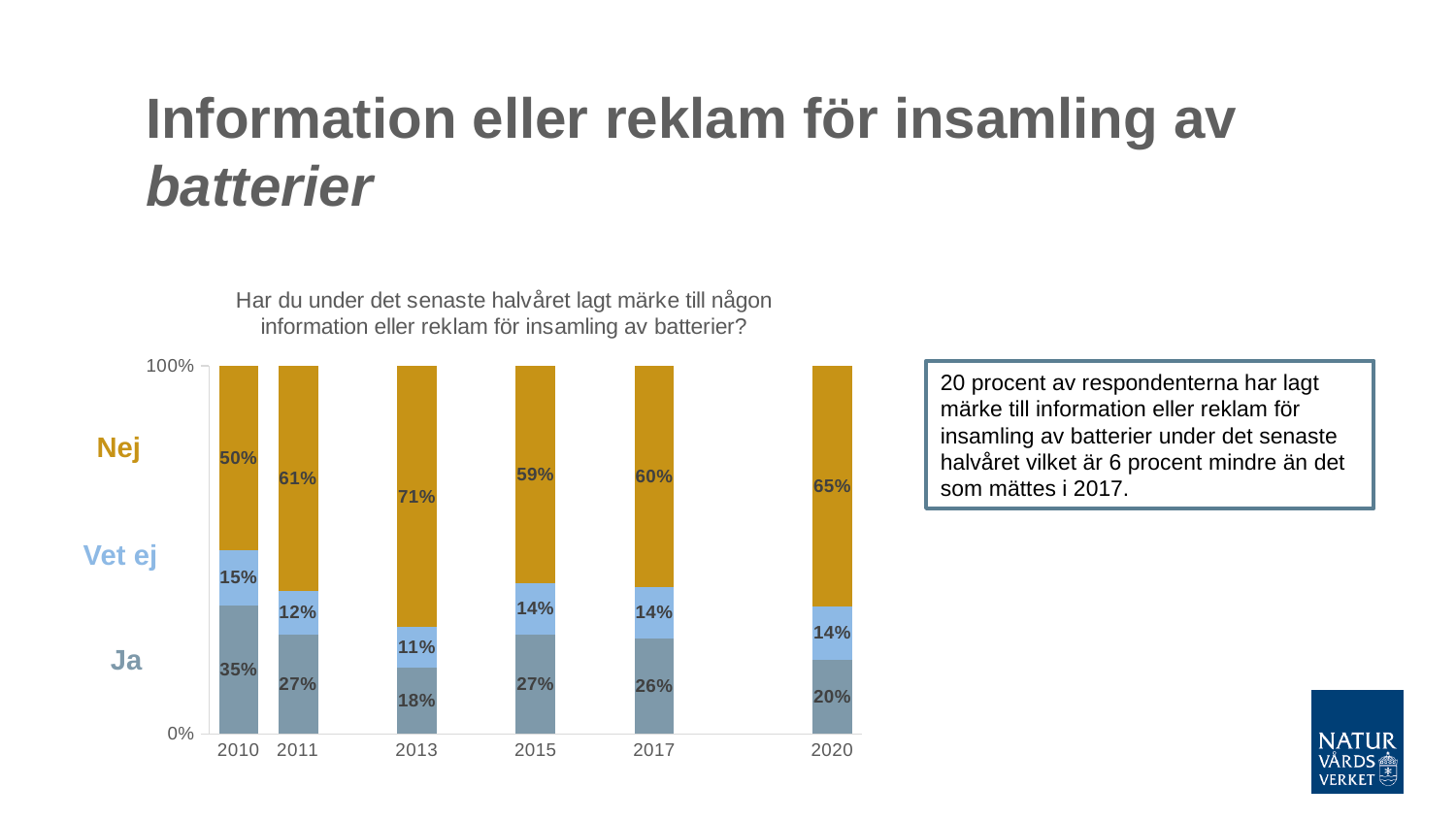
Which is larger, the "Nej" share in 2011 or in 2015? 2011 What percentage answered "Ja" in 2020? 20% What is the difference between the "Ja" share in 2017 and in 2020? 6% In which year was the "Ja" share highest? 2010 How many years are shown on the x axis? 6 What kind of chart is shown on the slide? Stacked bar chart What percentage answered "Nej" in 2013? 71% How many response categories are stacked in each bar? 3 What is the total of the "Ja" and "Vet ej" shares in 2013? 29% What percentage answered "Vet ej" in 2010? 15% Which response category is shown in orange? Nej In which year was the "Nej" share lowest? 2010